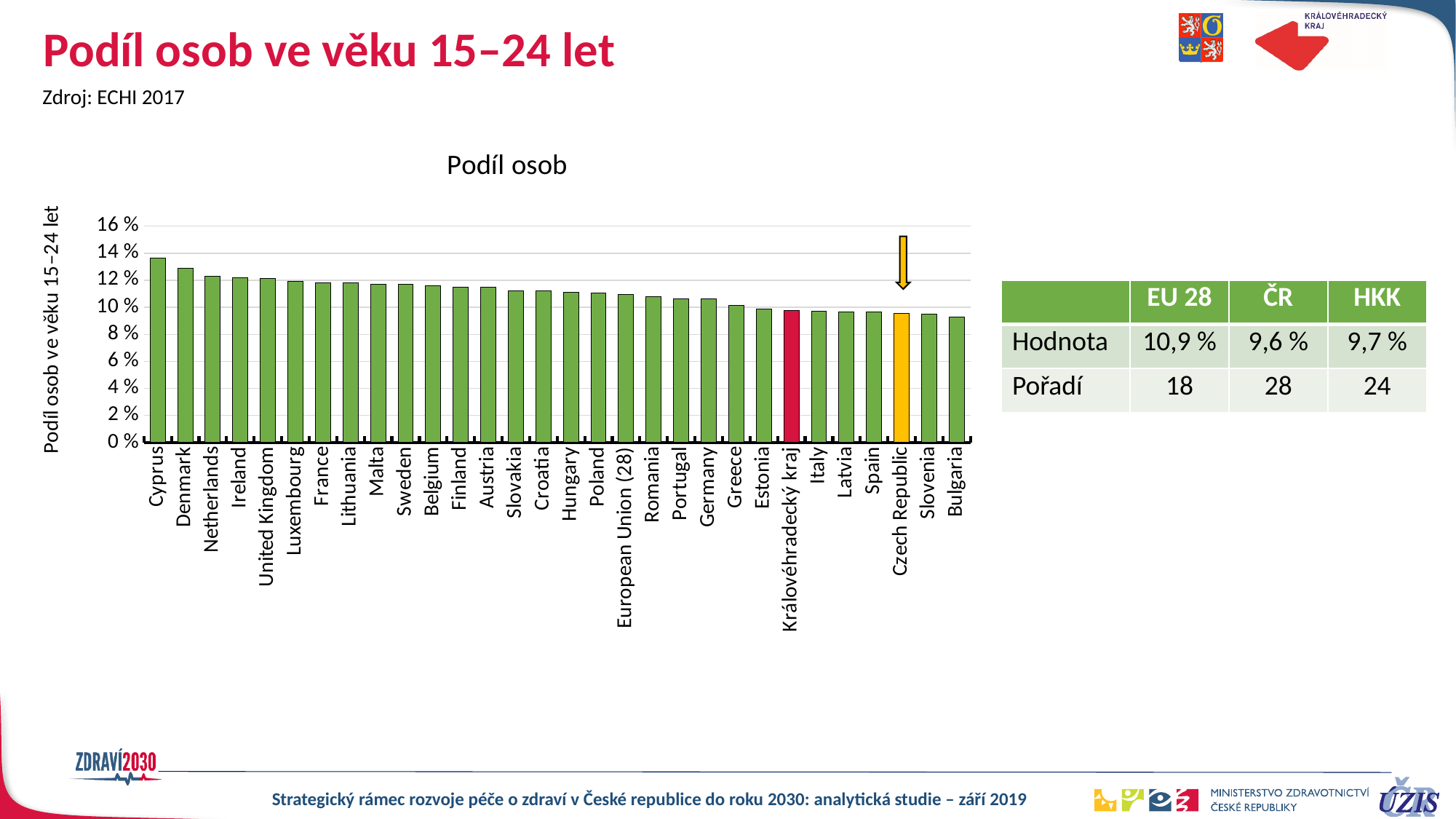
What is the difference between the value for EU 28 and the value for ČR in the table? 1,3 % What type of chart is shown on the slide? bar chart What is the value for European Union (28), as given in the table on the slide? 10,9 % Is the value for Cyprus greater or less than 12 %? greater How many categories (bars) are plotted in the chart? 30 Which category has the highest value in the chart? Cyprus Which is larger, the value for Cyprus or the value for Bulgaria? Cyprus Do the bar values rise or fall from left to right along the x axis? fall What is the value for Královéhradecký kraj (HKK), as given in the table on the slide? 9,7 % What is the value for Czech Republic, as given in the table on the slide? 9,6 % Is the value for Bulgaria greater or less than 10 %? less What is the title of the chart? Podíl osob